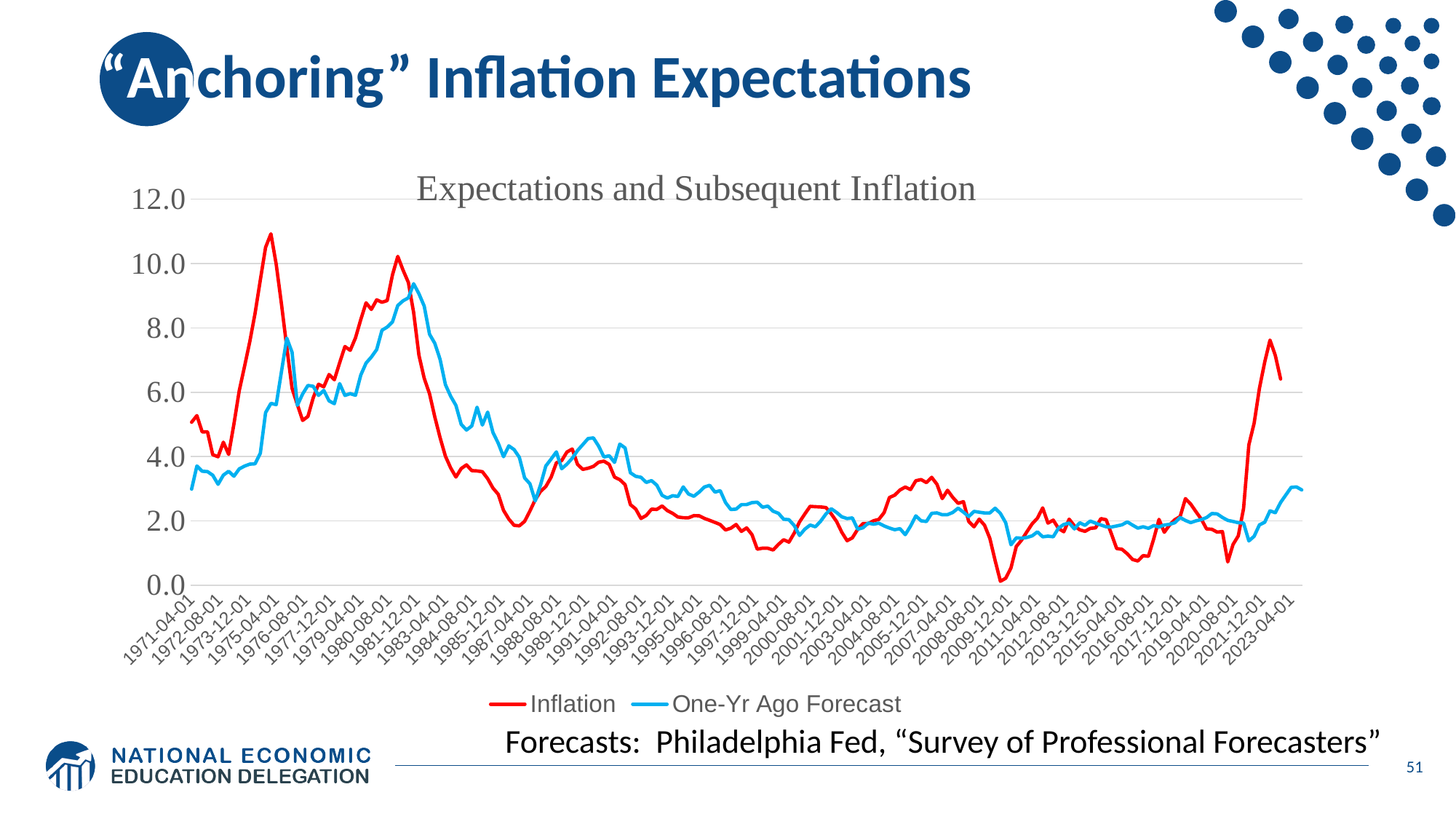
Which series reaches the highest value anywhere on the chart? Inflation Is the value of the One-Yr Ago Forecast series at the end of the chart (2023-04-01) greater or less than 4.0? less What is the title of the chart? Expectations and Subsequent Inflation How many series does the legend list? 2 Is the peak value of the Inflation series around 1975 greater or less than 10.0? greater Does the Inflation series rise or fall between 1981 and 1987? fall Is the peak value of the One-Yr Ago Forecast series around 1981 greater or less than 8.0? greater Does the Inflation series rise or fall between 2020 and 2022? rise Around 1975, which series is higher: Inflation or One-Yr Ago Forecast? Inflation What kind of chart is shown on the slide? line chart Which colour is used for the One-Yr Ago Forecast series? blue